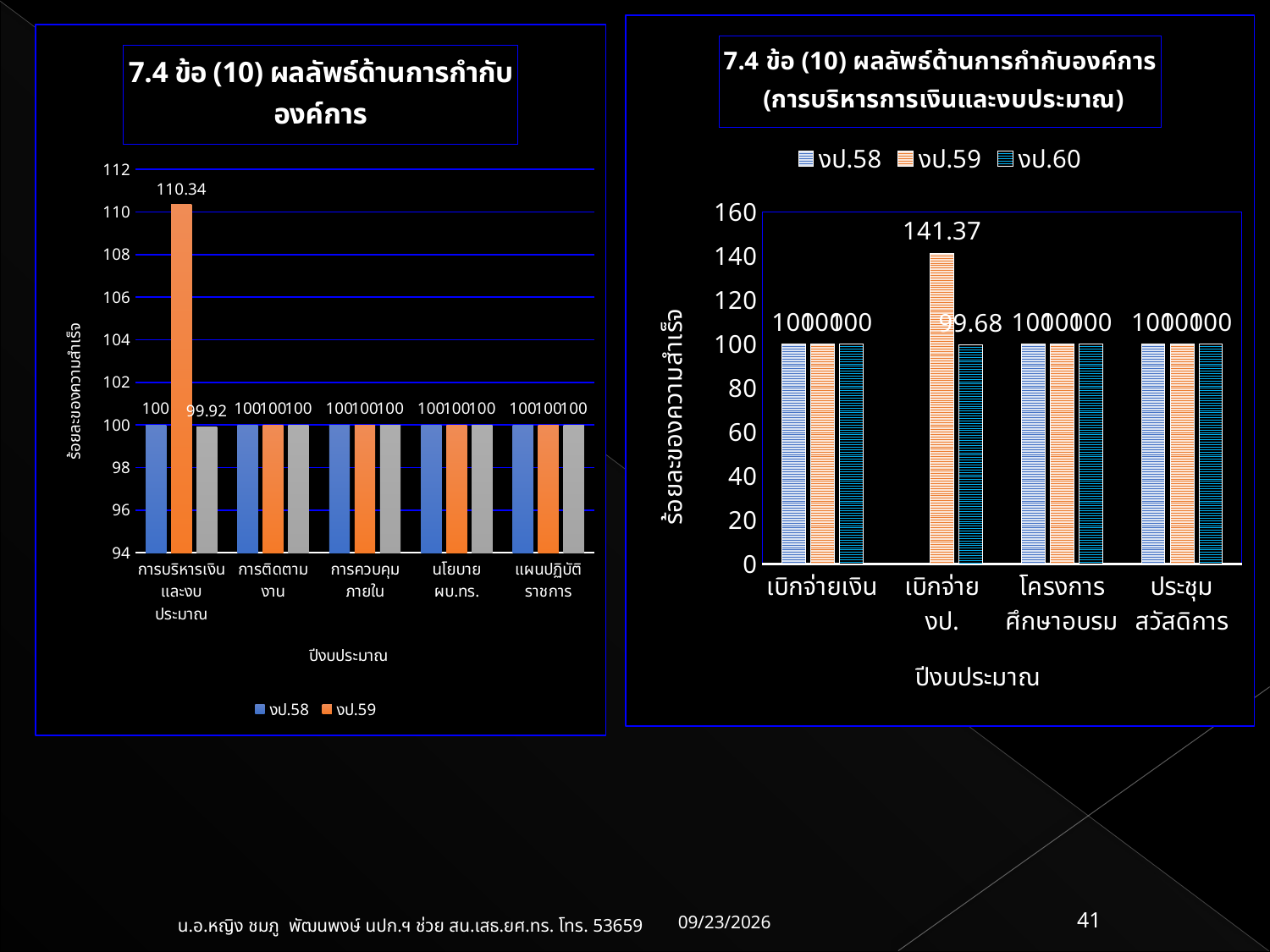
In the left chart, what is the value of the gray bar for การบริหารเงินและงบประมาณ? 99.92 What type of chart is the right chart? bar chart In the right chart, which category has the highest งป.59 value? เบิกจ่าย งป. In the left chart, how many series does the legend list? 2 In the left chart, what is the difference between the งป.59 value and the งป.58 value for การบริหารเงินและงบประมาณ? 10.34 In the right chart, is the งป.59 value for เบิกจ่าย งป. greater or less than 120? greater In the right chart, what is the value of งป.60 for เบิกจ่าย งป.? 99.68 In the right chart, what is the value of งป.59 for เบิกจ่าย งป.? 141.37 In the left chart, which category has the highest งป.59 value? การบริหารเงินและงบประมาณ In the left chart, how many categories are shown on the x axis? 5 In the left chart, what is the value of งป.59 for การบริหารเงินและงบประมาณ? 110.34 In the right chart, how many series does the legend list? 3